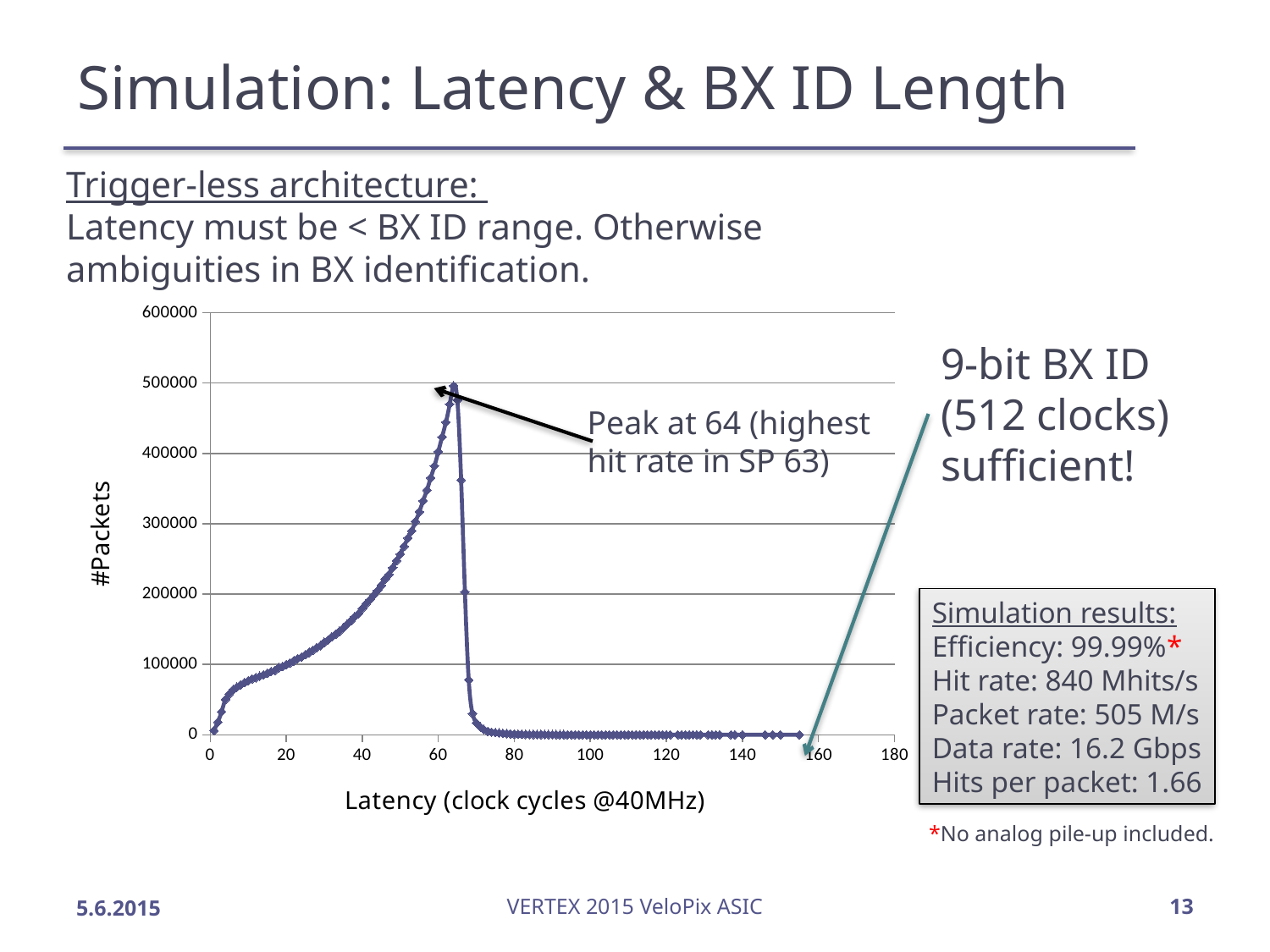
Which has more packets: a latency of 40 clock cycles or a latency of 120 clock cycles? 40 clock cycles Is the number of packets at a latency of 140 clock cycles greater or less than 100000? less What kind of chart is shown on the slide? line chart Is the number of packets at a latency of 20 clock cycles greater or less than 200000? less Is the number of packets at a latency of 40 clock cycles greater or less than 100000? greater At what latency does the number of packets peak, according to the annotation on the chart? 64 What is the label of the horizontal axis of the chart? Latency (clock cycles @40MHz) What is the label of the vertical axis of the chart? #Packets Does the number of packets rise or fall as latency increases from 64 to 80 clock cycles? fall Does the number of packets rise or fall as latency increases from 0 to 60 clock cycles? rise